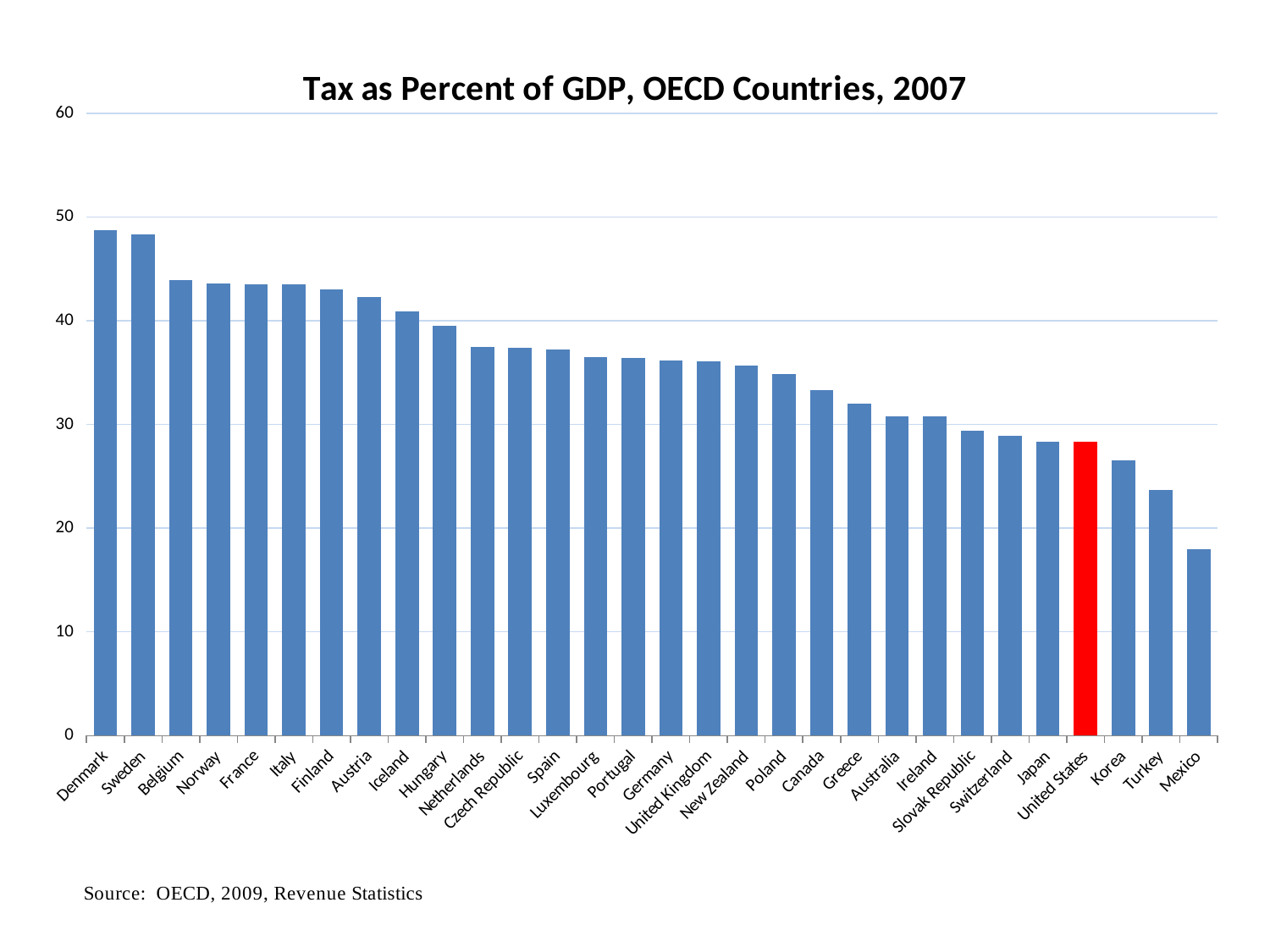
What kind of chart is shown on the slide? bar chart Is the value for Hungary greater or less than 40? less Which country's bar is highlighted in red? United States Is the value for Denmark greater or less than 40? greater Which has a higher tax as percent of GDP, Belgium or Canada? Belgium How many countries are shown in the chart? 30 Is the value for Mexico greater or less than 20? less Do the values rise or fall moving from left to right across the chart? fall Which has a higher tax as percent of GDP, Japan or Germany? Germany Which country has the lowest tax as percent of GDP? Mexico